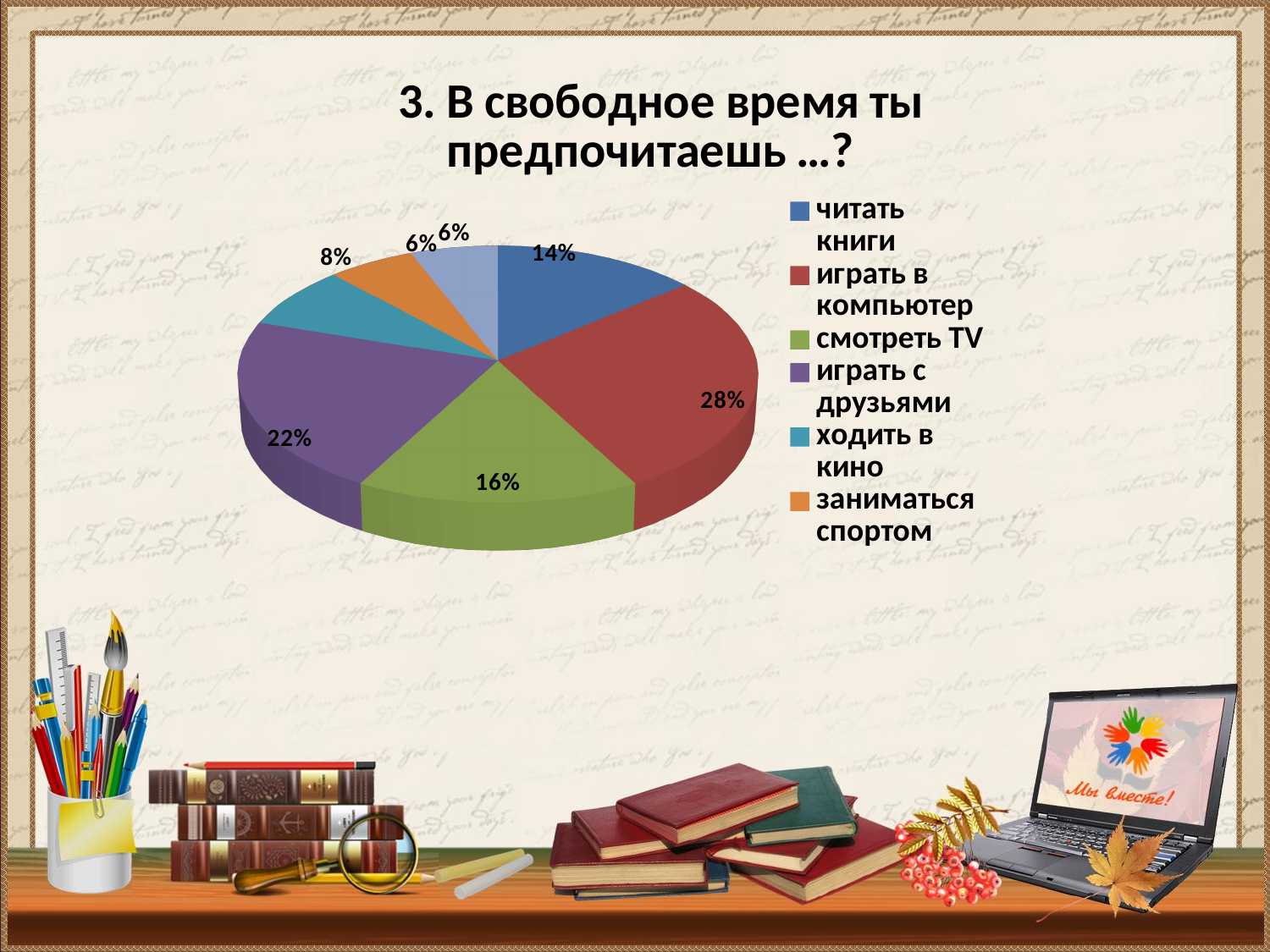
What is the value for "ходить в кино"? 8% What percentage is shown for "заниматься спортом"? 6% What percentage is labelled for "смотреть TV"? 16% Which is larger: the slice for "играть с друзьями" or the slice for "смотреть TV"? играть с друзьями What kind of chart is shown on the slide? pie chart How many entries does the legend list? 6 What is the value shown for "играть с друзьями"? 22% What colour is the slice for "играть в компьютер"? red What percentage of the pie is for "играть в компьютер"? 28% Which category has the largest slice of the pie? играть в компьютер How many percentage points larger is "играть в компьютер" than "читать книги"? 14% What share does "читать книги" have in the pie chart? 14%